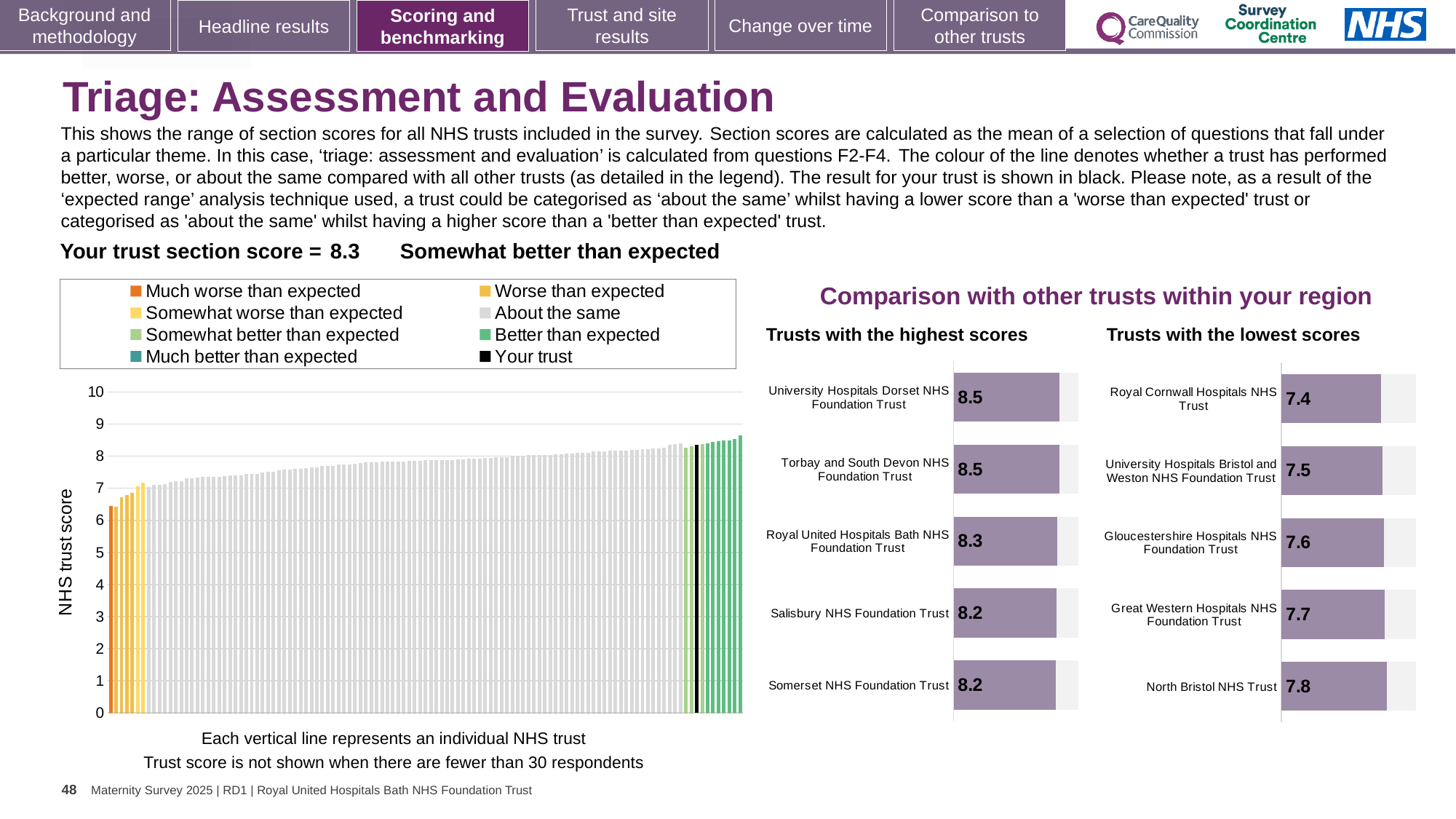
In the 'Trusts with the highest scores' chart, what is the score for Royal United Hospitals Bath NHS Foundation Trust? 8.3 How many trusts are shown in the 'Trusts with the highest scores' chart? 5 What type of chart is the 'Trusts with the lowest scores' chart? Bar chart In the 'Trusts with the lowest scores' chart, which trust has the lowest score? Royal Cornwall Hospitals NHS Trust In the 'Trusts with the highest scores' chart, what is the difference between the score for University Hospitals Dorset NHS Foundation Trust and the score for Somerset NHS Foundation Trust? 0.3 In the large chart on the left, is the value of the black bar (your trust) greater or less than 8? greater In the 'Trusts with the lowest scores' chart, which trust has the highest score? North Bristol NHS Trust In the 'Trusts with the lowest scores' chart, which has the larger score: Great Western Hospitals NHS Foundation Trust or University Hospitals Bristol and Weston NHS Foundation Trust? Great Western Hospitals NHS Foundation Trust In the large chart on the left, do the trust scores rise or fall from left to right along the x axis? Rise How many entries does the legend above the large chart on the left list? 8 What is the label on the vertical axis of the large chart on the left? NHS trust score In the 'Trusts with the lowest scores' chart, what is the score for Gloucestershire Hospitals NHS Foundation Trust? 7.6